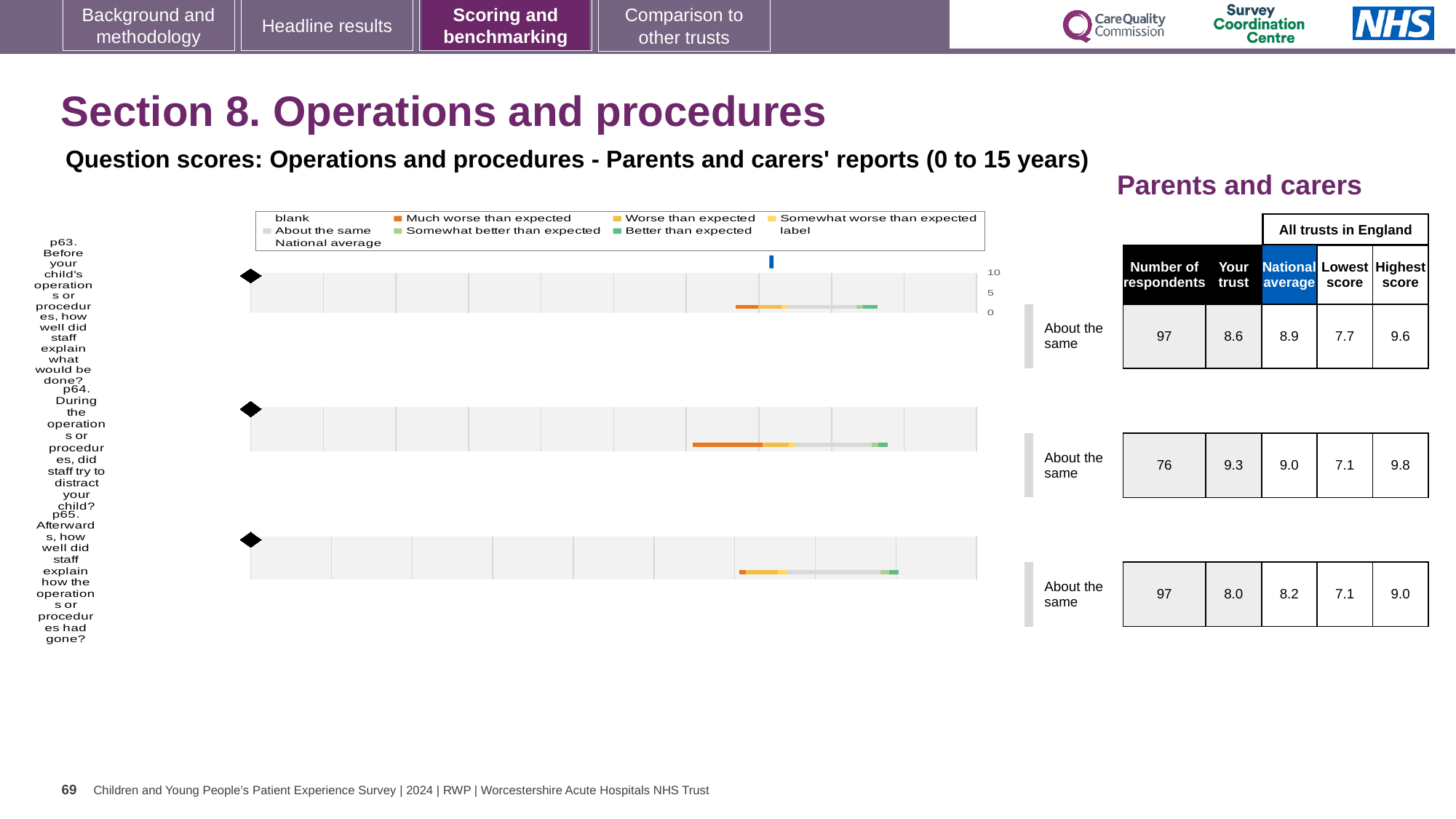
How many questions (p63, p64, p65) are plotted on the slide? 3 How many respondents answered p64? 76 Which of the three questions has the lowest 'Your trust' score? p65 What benchmark category is shown for all three questions? About the same What is the 'Your trust' score for p65 (Afterwards, how well did staff explain how the operations or procedures had gone?)? 8.0 What is the national average score for p64 (During the operations or procedures, did staff try to distract your child?)? 9.0 What is the lowest score across all trusts in England for p63? 7.7 What is the difference between the 'Your trust' score and the national average for p63? 0.3 What is the 'Your trust' score for p63 (Before your child's operations or procedures, how well did staff explain what would be done?)? 8.6 What kind of chart is used to show the question scores on this slide? bar chart What is the highest score across all trusts in England for p64? 9.8 Which of the three questions has the highest 'Your trust' score? p64